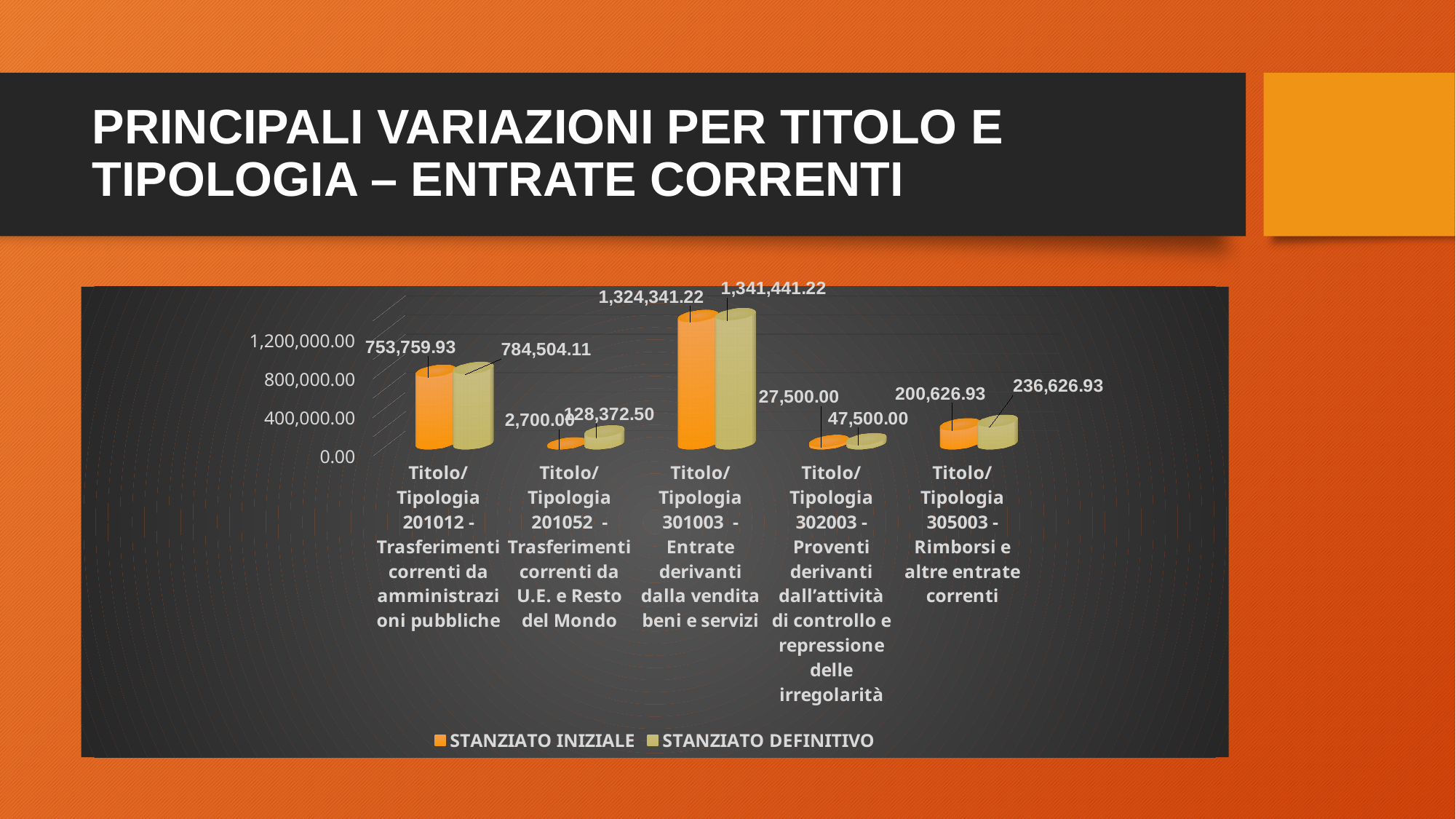
How many categories are shown on the x axis of the chart? 5 Which category has the lowest STANZIATO INIZIALE value? Titolo/Tipologia 201052 - Trasferimenti correnti da U.E. e Resto del Mondo What is the difference between STANZIATO DEFINITIVO and STANZIATO INIZIALE for Titolo/Tipologia 302003? 20,000.00 Which category has the highest STANZIATO DEFINITIVO value? Titolo/Tipologia 301003 - Entrate derivanti dalla vendita beni e servizi What is the difference between STANZIATO DEFINITIVO and STANZIATO INIZIALE for Titolo/Tipologia 305003 - Rimborsi e altre entrate correnti? 36,000.00 What kind of chart is shown on the slide? Bar chart What is the STANZIATO INIZIALE value for Titolo/Tipologia 201052 - Trasferimenti correnti da U.E. e Resto del Mondo? 2,700.00 For Titolo/Tipologia 201012, which is larger: STANZIATO INIZIALE or STANZIATO DEFINITIVO? STANZIATO DEFINITIVO What is the STANZIATO INIZIALE value for Titolo/Tipologia 201012 - Trasferimenti correnti da amministrazioni pubbliche? 753,759.93 What is the STANZIATO DEFINITIVO value for Titolo/Tipologia 302003 - Proventi derivanti dall'attività di controllo e repressione delle irregolarità? 47,500.00 How many series does the legend list? 2 What is the STANZIATO DEFINITIVO value for Titolo/Tipologia 301003 - Entrate derivanti dalla vendita beni e servizi? 1,341,441.22